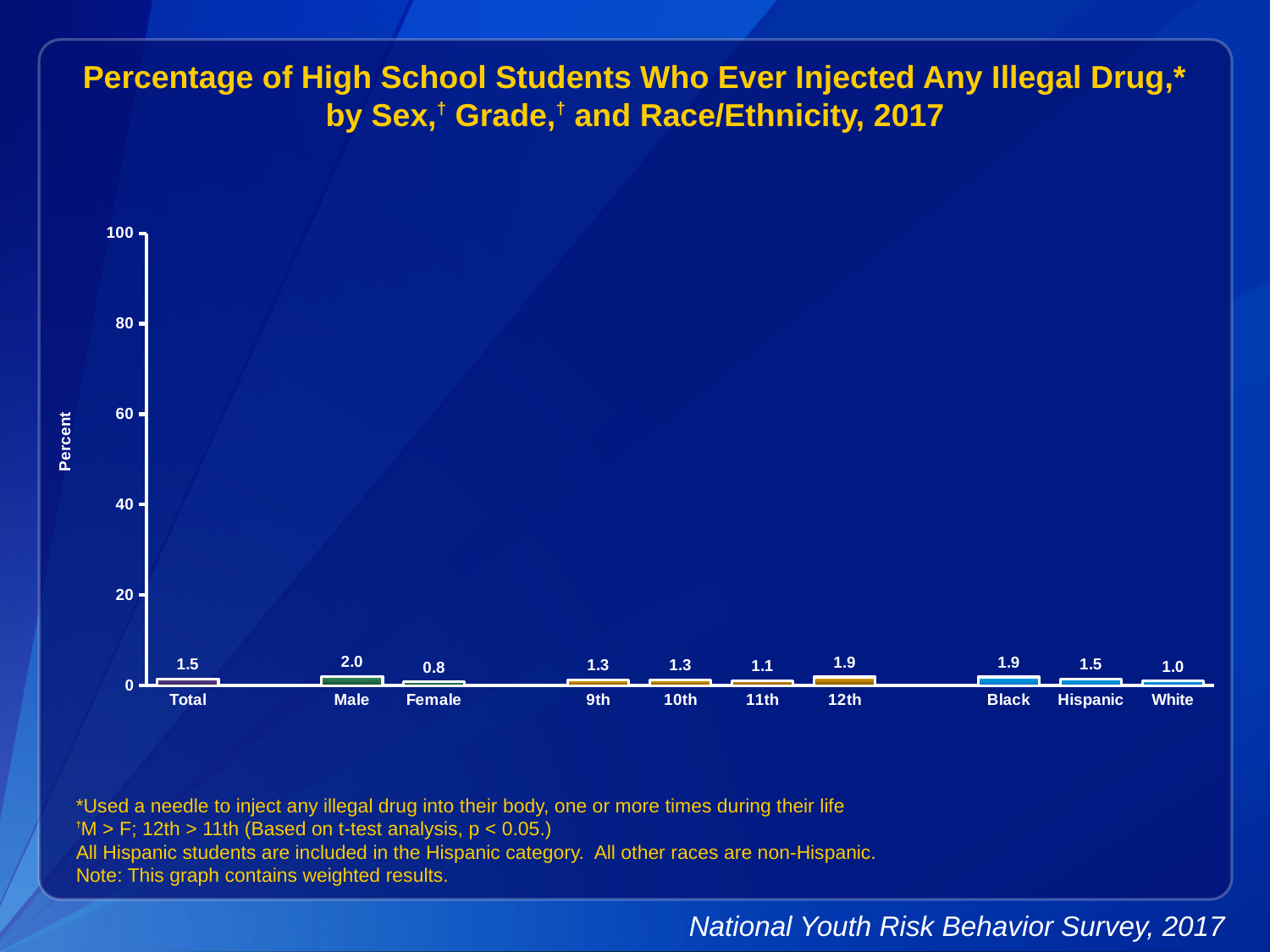
Is the value for Hispanic greater or less than 20? less What is the value for Total? 1.5 What kind of chart is this? bar chart Which is larger, the value for Black or the value for White? Black What is the value for Female? 0.8 Which category has the lowest value? Female How many categories are shown on the x axis? 10 Which category has the highest value? Male What is the value for Male? 2.0 What is the value for 12th grade? 1.9 What is the difference between the values for Male and Female? 1.2 What is the label of the y axis? Percent